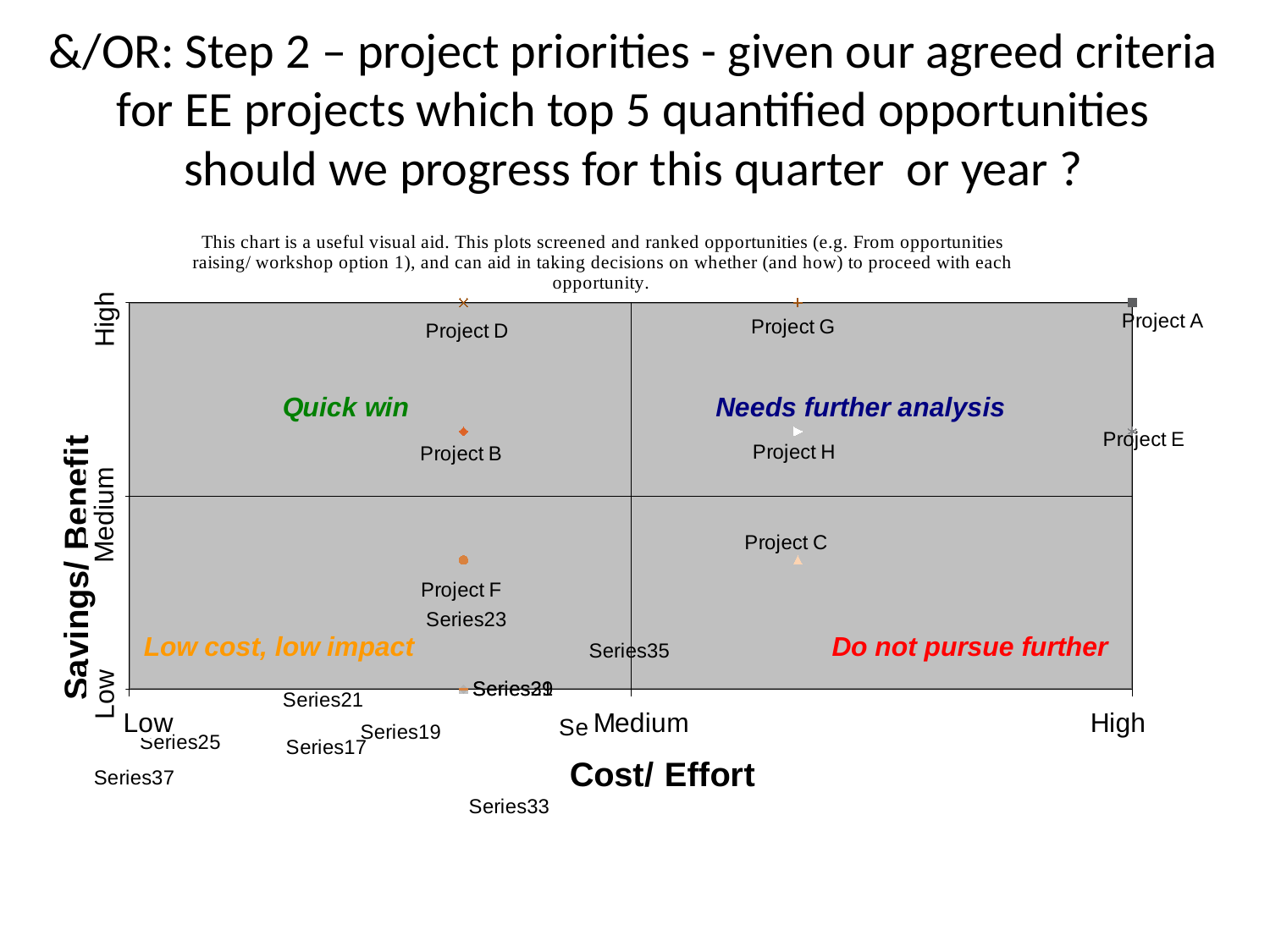
In which quadrant of the chart is Project F plotted? Low cost, low impact In which quadrant of the chart is Project H plotted? Needs further analysis What kind of chart is shown on the slide? scatter chart Which has the higher Savings/ Benefit on the chart, Project B or Project F? Project B In which quadrant of the chart is Project D plotted? Quick win How many projects (labelled Project A to Project H) are plotted on the chart? 8 Which has the higher Savings/ Benefit on the chart, Project H or Project C? Project H What is the title of the horizontal axis of the chart? Cost/ Effort What is the title of the vertical axis of the chart? Savings/ Benefit Which has the higher Cost/ Effort on the chart, Project B or Project G? Project G In which quadrant of the chart is Project C plotted? Do not pursue further